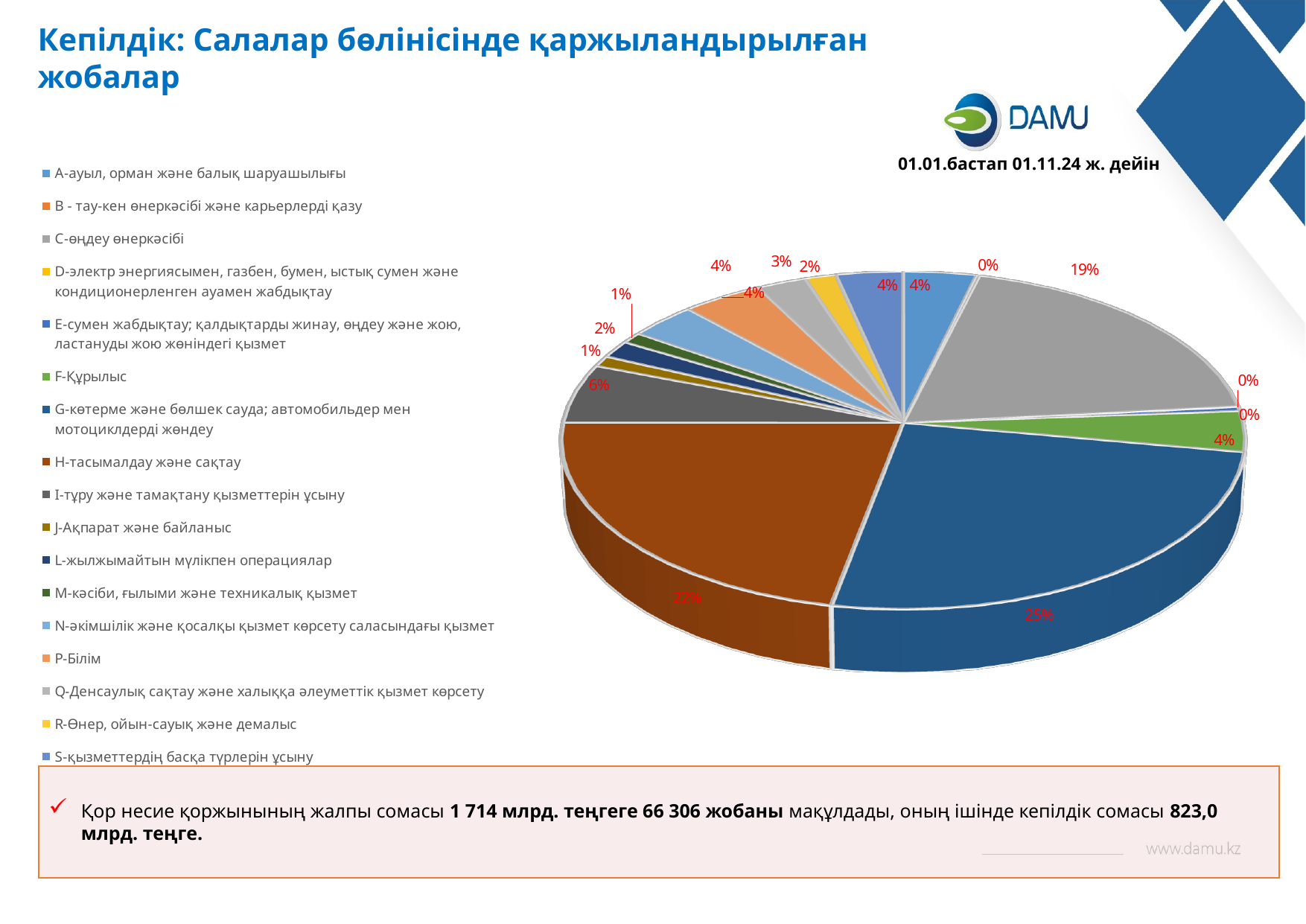
What share of the pie does C-өңдеу өнеркәсібі have? 19% What share of the pie does I-тұру және тамақтану қызметтерін ұсыну have? 6% What period does the chart cover, according to the text above it? 01.01.бастап 01.11.24 ж. дейін Which has the larger share: C-өңдеу өнеркәсібі or H-тасымалдау және сақтау? H-тасымалдау және сақтау What share of the pie does G-көтерме және бөлшек сауда; автомобильдер мен мотоциклдерді жөндеу have? 25% How many categories does the legend of the pie chart list? 17 Which category has the largest share of the pie? G-көтерме және бөлшек сауда; автомобильдер мен мотоциклдерді жөндеу What is the difference in percentage points between the shares of G-көтерме және бөлшек сауда and H-тасымалдау және сақтау? 3 percentage points What is the difference in percentage points between the shares of G-көтерме және бөлшек сауда and C-өңдеу өнеркәсібі? 6 percentage points What kind of chart is shown on the slide? Pie chart